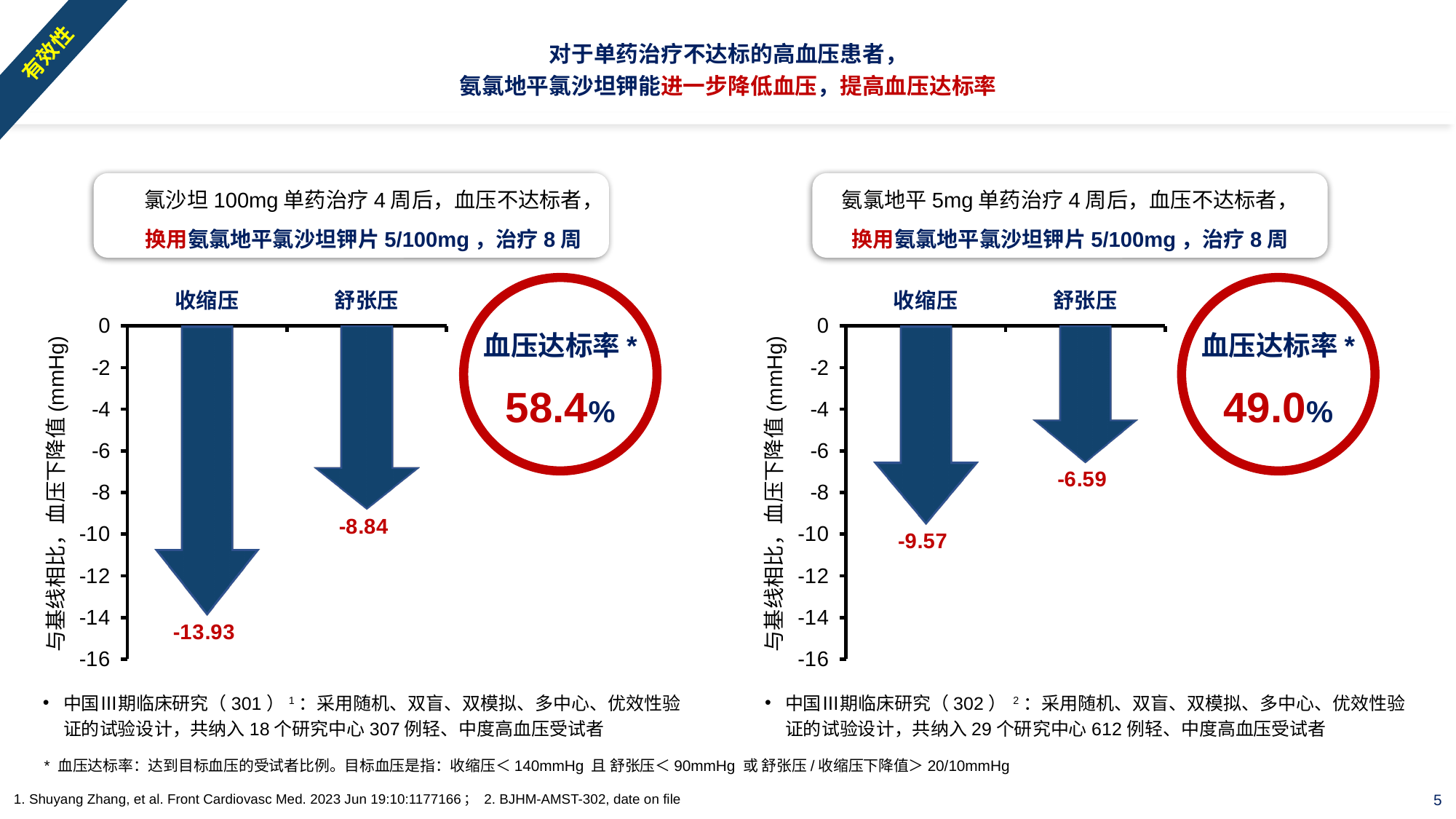
How many categories are plotted in the left chart? 2 In the left chart, what is the value for 舒张压? -8.84 In the right chart, what is the difference between the 收缩压 and 舒张压 reductions? 2.98 In the left chart, what is the difference between the 收缩压 and 舒张压 reductions? 5.09 What is the 血压达标率 shown next to the right chart? 49.0% In the right chart, what is the value for 收缩压? -9.57 In the right chart, what is the value for 舒张压? -6.59 In the left chart, which category shows the larger blood pressure reduction? 收缩压 What is the y-axis label of the left chart? 与基线相比，血压下降值 (mmHg) In the left chart, what is the value for 收缩压? -13.93 In the right chart, which category shows the smaller blood pressure reduction? 舒张压 What type of chart is the right chart? bar chart